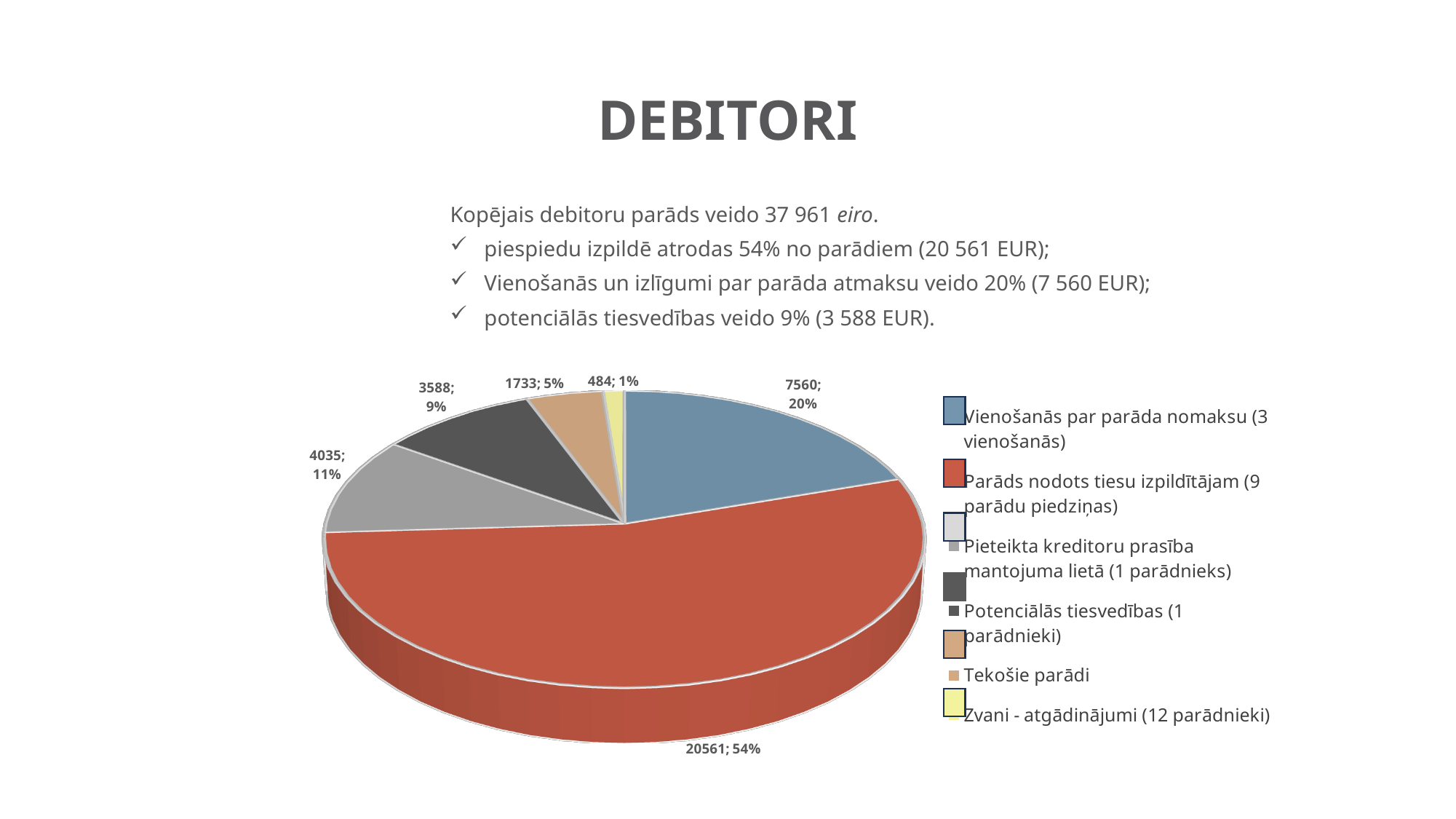
What is the difference between the values for 'Parāds nodots tiesu izpildītājam (9 parādu piedziņas)' and 'Vienošanās par parāda nomaksu (3 vienošanās)'? 13001 Which slice of the pie chart is the largest? Parāds nodots tiesu izpildītājam (9 parādu piedziņas) Which slice of the pie chart is the smallest? Zvani - atgādinājumi (12 parādnieki) What kind of chart is shown on the slide? pie chart How many entries does the legend of the pie chart list? 6 What is the title of the slide containing the pie chart? DEBITORI What share of the pie does 'Zvani - atgādinājumi (12 parādnieki)' represent? 1% What value is shown for the slice 'Parāds nodots tiesu izpildītājam (9 parādu piedziņas)'? 20561 What value is shown for 'Potenciālās tiesvedības (1 parādnieki)'? 3588 How many slices does the pie chart have? 6 Which is larger: the value for 'Pieteikta kreditoru prasība mantojuma lietā (1 parādnieks)' or the value for 'Tekošie parādi'? Pieteikta kreditoru prasība mantojuma lietā (1 parādnieks) What share of the pie does 'Vienošanās par parāda nomaksu (3 vienošanās)' represent? 20%